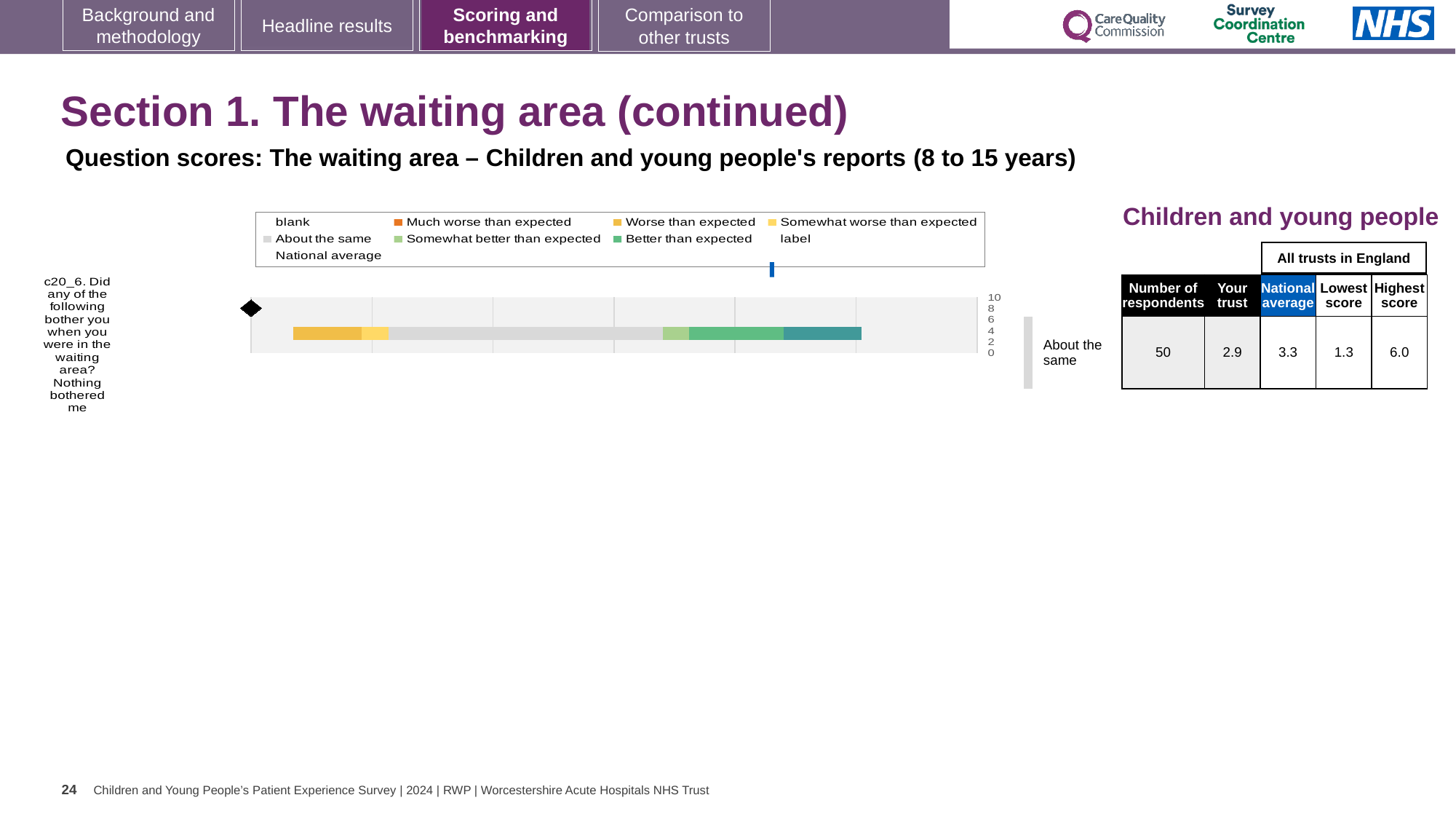
What is the highest score among all trusts in England for question c20_6? 6.0 What is the difference between the highest score and the lowest score for question c20_6? 4.7 Which benchmark category is the trust's result for question c20_6 placed in, as labelled to the right of the bar? About the same By how much does the national average exceed the trust's score for question c20_6? 0.4 What is the lowest score among all trusts in England for question c20_6? 1.3 How many respondents answered question c20_6? 50 Which is larger for question c20_6: the trust's score or the national average? national average What kind of chart is shown on the slide? bar chart What is the 'Your trust' score for question c20_6 in the table? 2.9 What is the national average score for question c20_6? 3.3 How many survey questions are plotted in the chart? 1